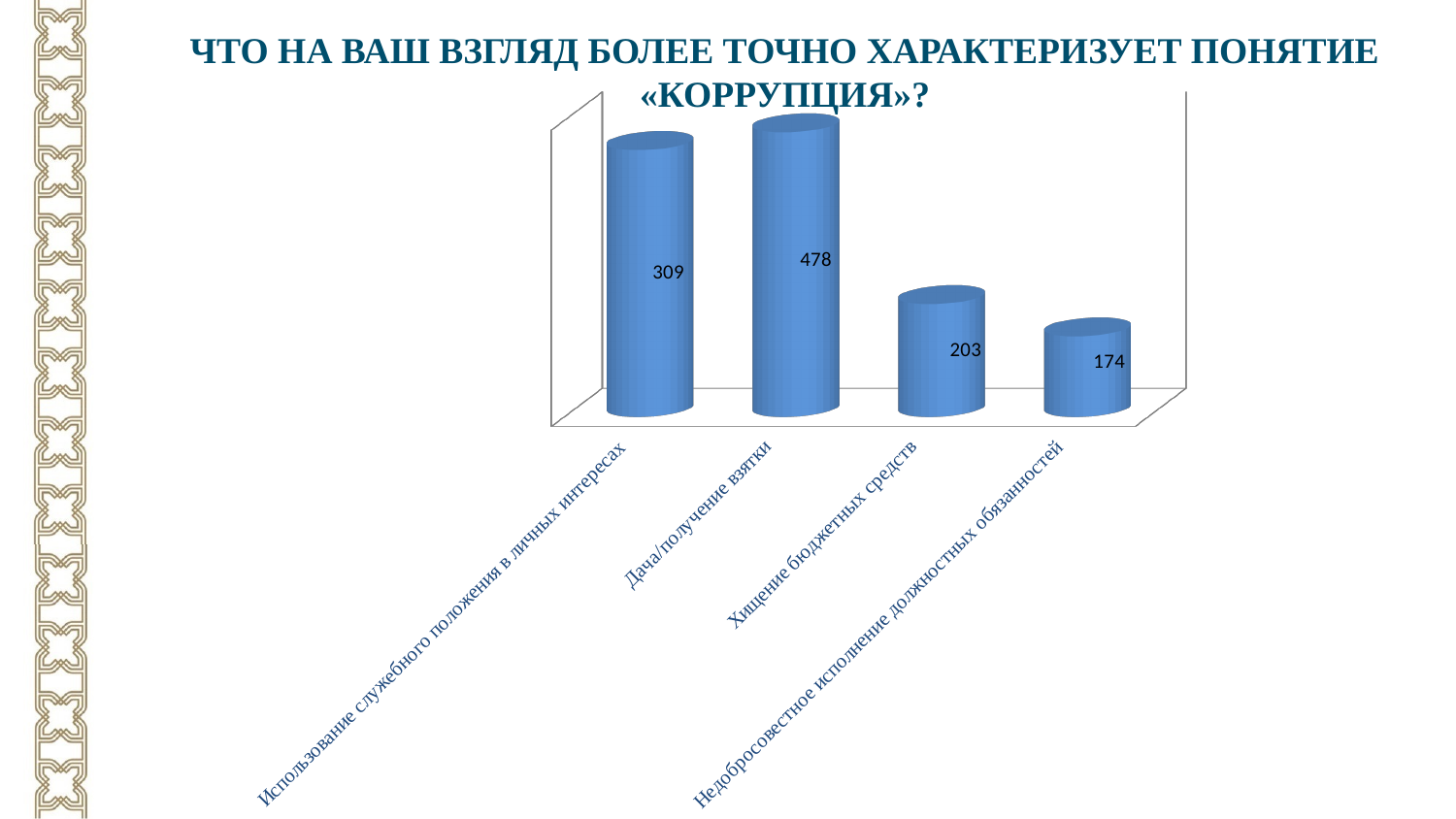
What is the difference between the values for «Хищение бюджетных средств» and «Недобросовестное исполнение должностных обязанностей»? 29 Which category has the highest value? Дача/получение взятки What is the value for «Использование служебного положения в личных интересах»? 309 What is the value for «Недобросовестное исполнение должностных обязанностей»? 174 What is the title of the chart? ЧТО НА ВАШ ВЗГЛЯД БОЛЕЕ ТОЧНО ХАРАКТЕРИЗУЕТ ПОНЯТИЕ «КОРРУПЦИЯ»? What kind of chart is shown on the slide? Bar chart What is the difference between the values for «Дача/получение взятки» and «Использование служебного положения в личных интересах»? 169 How many categories are shown in the chart? 4 What is the value for «Дача/получение взятки»? 478 Which is larger: the value for «Использование служебного положения в личных интересах» or for «Хищение бюджетных средств»? Использование служебного положения в личных интересах What is the value for «Хищение бюджетных средств»? 203 Which category has the lowest value? Недобросовестное исполнение должностных обязанностей